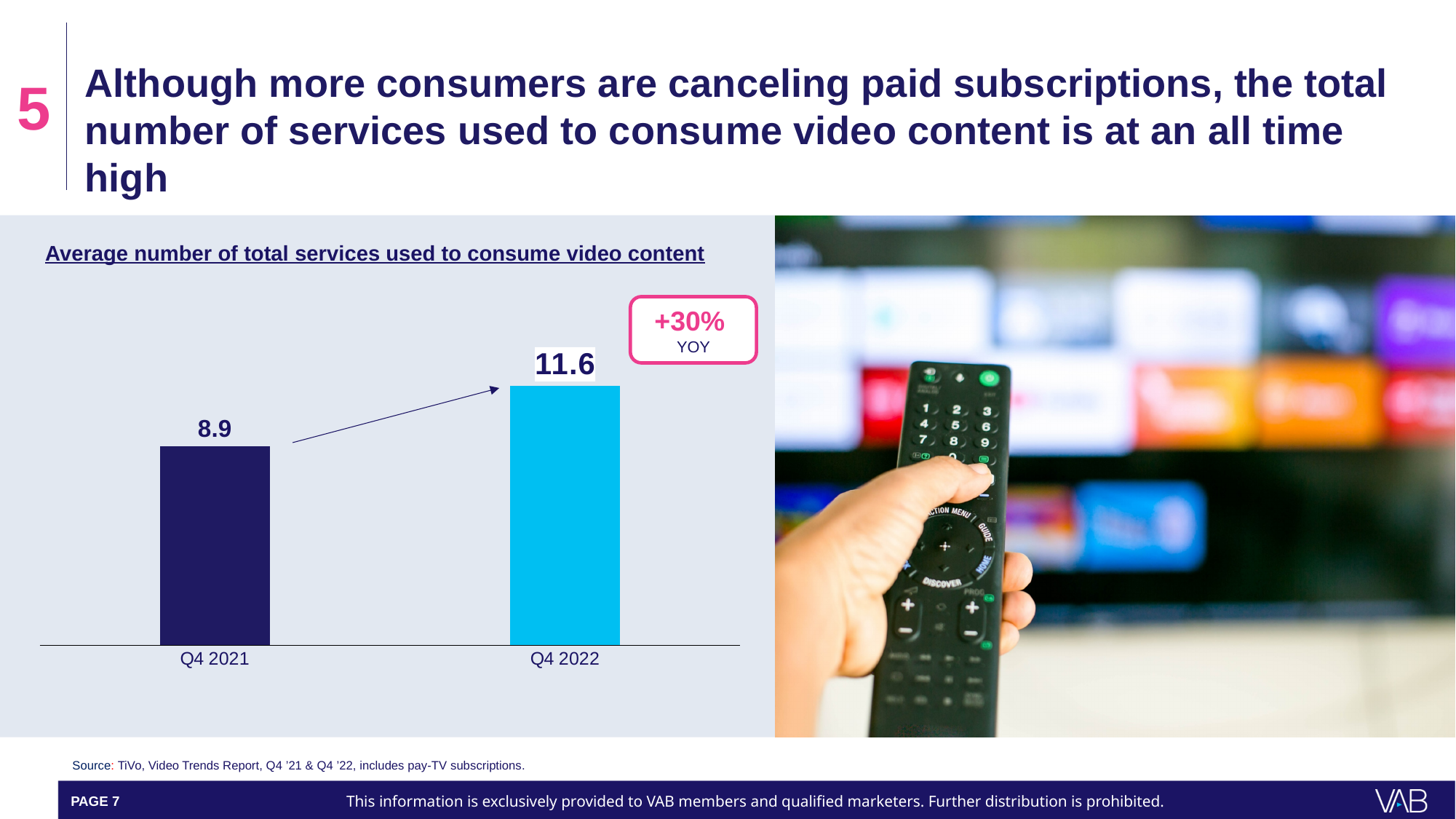
What is the difference between the Q4 2022 and Q4 2021 values for average number of total services used? 2.7 What is the average number of total services used to consume video content in Q4 2021? 8.9 Which quarter has the lower average number of total services used to consume video content? Q4 2021 What is the average number of total services used to consume video content in Q4 2022? 11.6 What kind of chart is used to show the average number of total services used to consume video content? bar chart What year-over-year percentage change is called out on the chart? +30% Do the values rise or fall from Q4 2021 to Q4 2022? rise Which quarter has the higher average number of total services used to consume video content? Q4 2022 How many categories are shown on the x axis of the chart? 2 Is the value for Q4 2022 larger or smaller than the value for Q4 2021? larger What is the title of the chart? Average number of total services used to consume video content